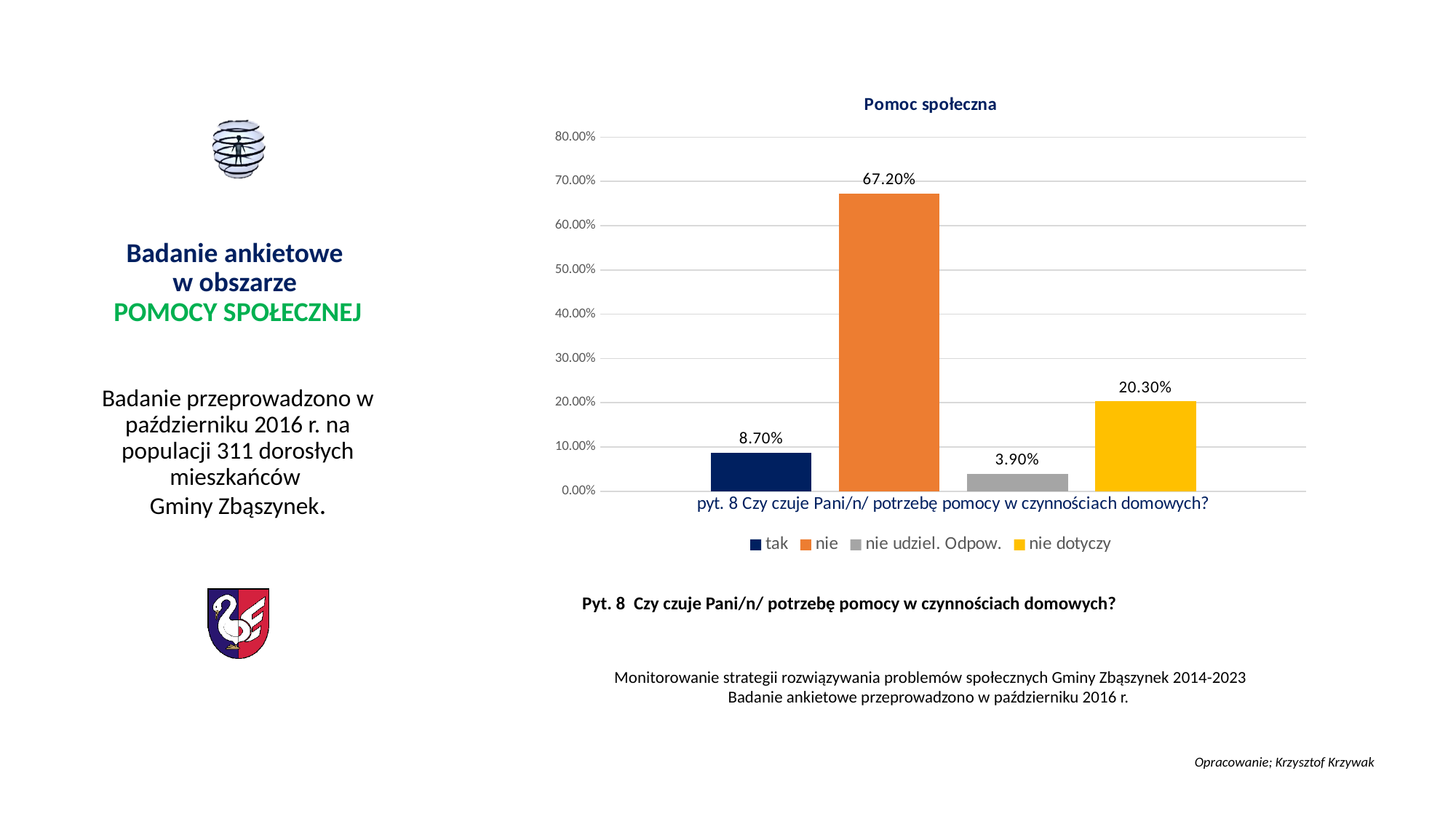
Is the value for "nie" greater or less than 60.00%? greater What kind of chart is shown on the slide? bar chart Which is larger, the value for "tak" or the value for "nie dotyczy"? nie dotyczy What is the value for "tak" in the chart? 8.70% What is the value for "nie dotyczy" in the chart? 20.30% What is the value for "nie udziel. Odpow." in the chart? 3.90% Which series has the lowest value in the chart? nie udziel. Odpow. How many series does the legend list? 4 Which series has the highest value in the chart? nie What is the value for "nie" in the chart? 67.20% What is the title of the chart? Pomoc społeczna What is the difference between the values for "nie" and "nie dotyczy"? 46.90%